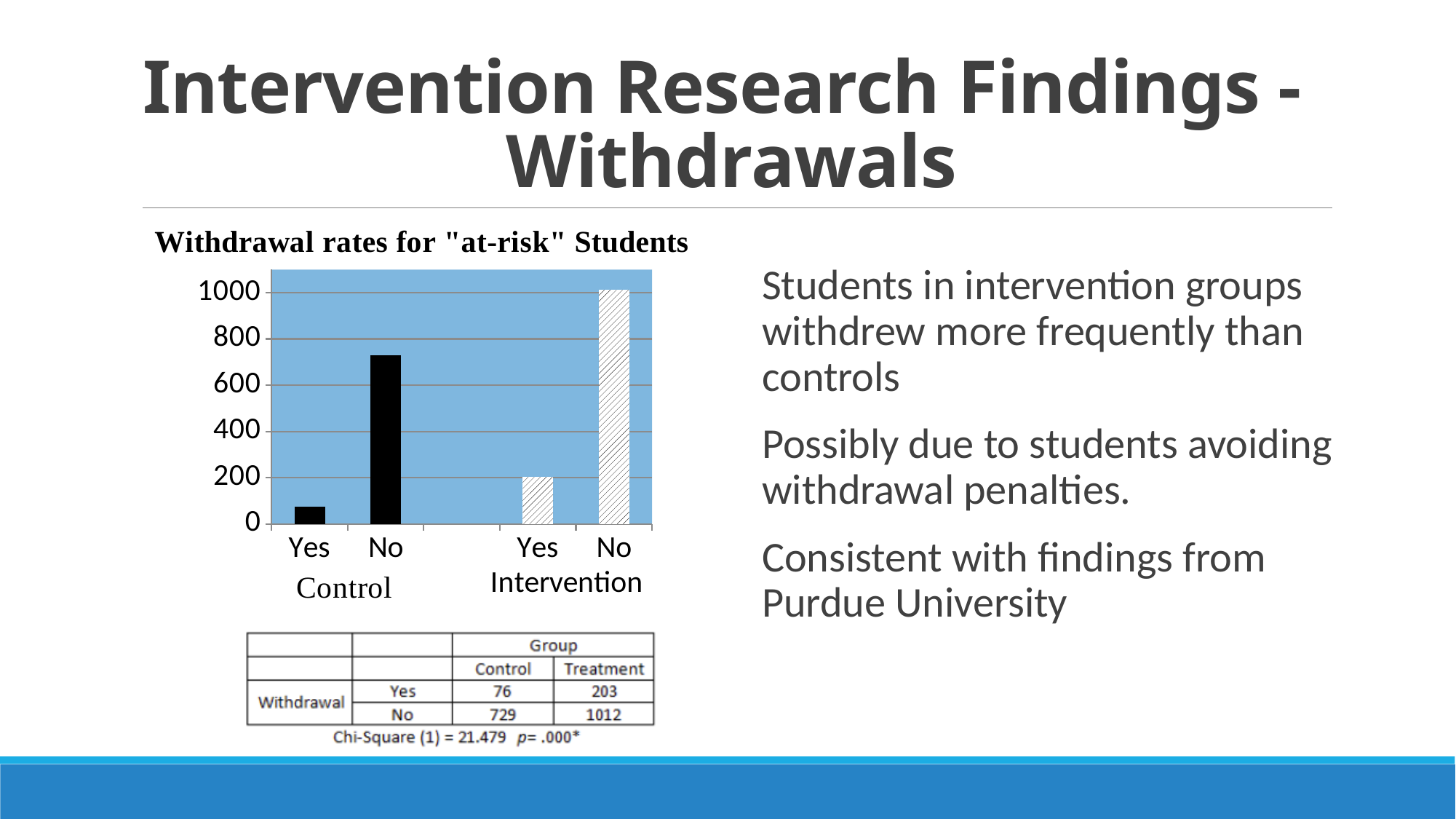
According to the table below the chart, how many Control students withdrew (Yes)? 76 Which bar in the withdrawal rates chart is the tallest? Intervention No What kind of chart is shown under the title "Withdrawal rates for "at-risk" Students"? bar chart Which is larger in the withdrawal rates chart: the Intervention "Yes" bar or the Control "Yes" bar? Intervention "Yes" According to the table below the chart, how many Treatment students did not withdraw (No)? 1012 Using the table values, what is the difference between Treatment "Yes" and Control "Yes" withdrawals? 127 How many bars are plotted in the withdrawal rates chart? 4 Is the value for the Control "No" bar greater or less than 600? greater What is the title of the chart on the slide? Withdrawal rates for "at-risk" Students Is the value for the Control "Yes" bar greater or less than 200? less Is the value for the Intervention "No" bar greater or less than 1000? greater Which bar in the withdrawal rates chart is the shortest? Control Yes